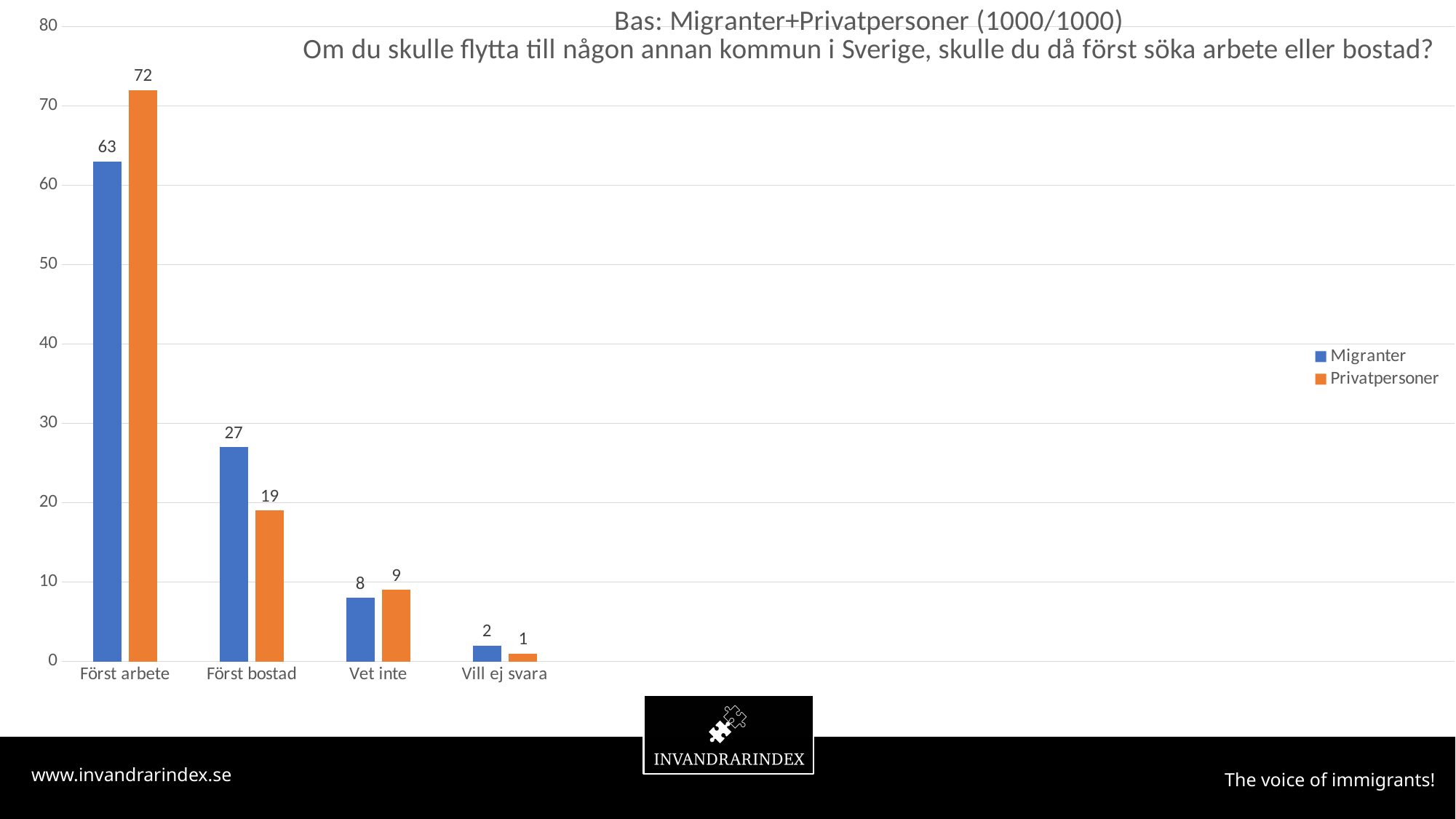
What is the value for Privatpersoner in the Först bostad category? 19 Which category has the lowest value for Migranter? Vill ej svara What kind of chart is shown on the slide? Bar chart Which category has the highest value for Privatpersoner? Först arbete What is the difference between the Privatpersoner and Migranter values for Först arbete? 9 What is the value for Migranter in the Vet inte category? 8 Which colour represents the Privatpersoner series? Orange How many categories are shown on the x axis? 4 What is the difference between the Migranter and Privatpersoner values for Först bostad? 8 Which is larger for Vet inte: Migranter or Privatpersoner? Privatpersoner What is the value for Migranter in the Först arbete category? 63 How many series does the legend list? 2